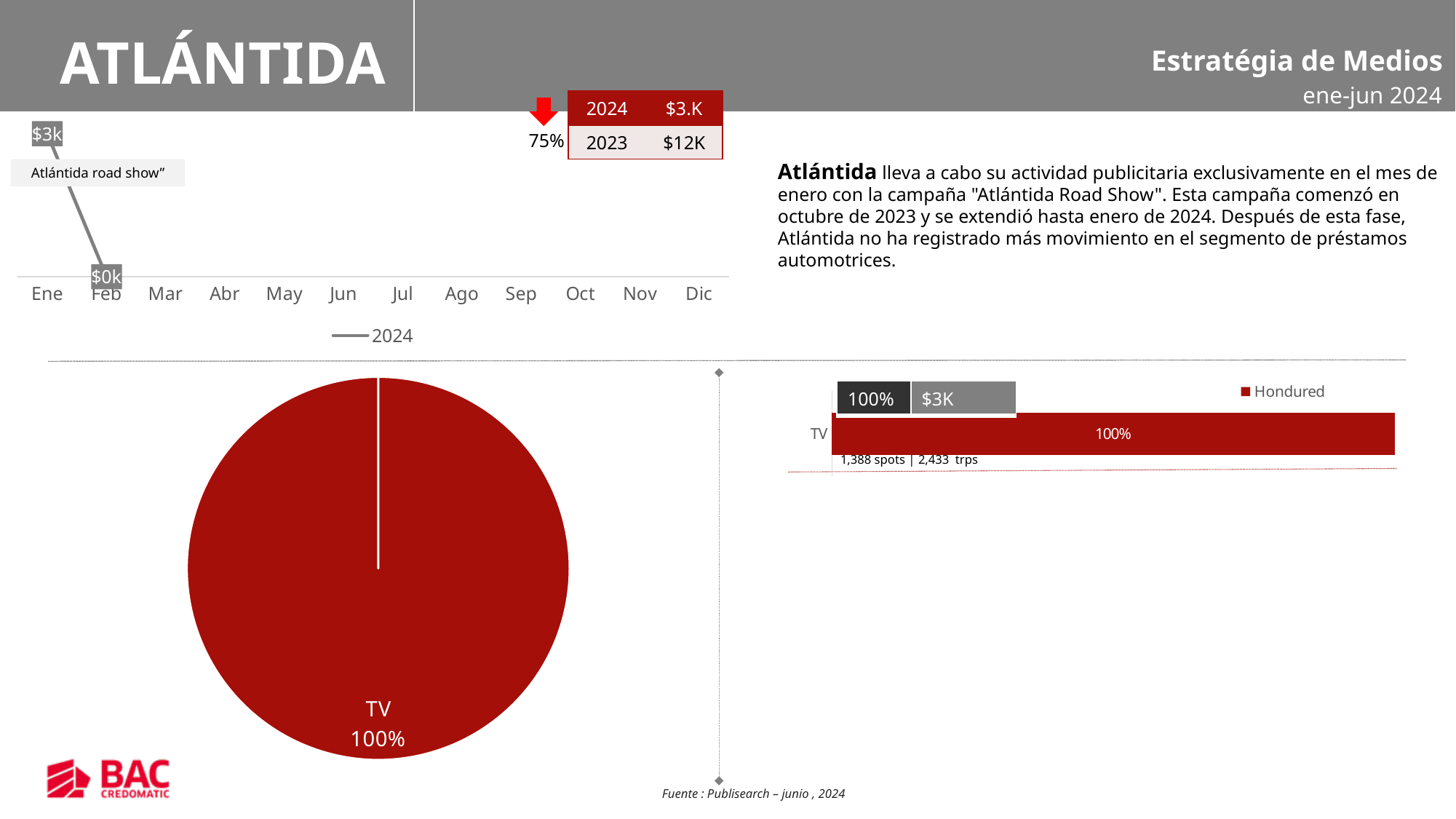
What kind of chart is shown at the bottom left of the slide? pie chart In the line chart at the top left, which month has the highest value? Ene In the line chart at the top left, how many series does the legend list? 1 In the pie chart at the bottom left, how many slices are there? 1 In the line chart at the top left, does the value rise or fall from Ene to Feb? fall What kind of chart is shown at the bottom right of the slide? bar chart In the line chart at the top left, what is the value for Feb? $0k In the pie chart at the bottom left, what share does TV have? 100% In the line chart at the top left, what is the value for Ene? $3k In the line chart at the top left, what series name appears in the legend? 2024 In the bar chart at the bottom right, what series name appears in the legend? Hondured In the line chart at the top left, how many months are shown on the x axis? 12